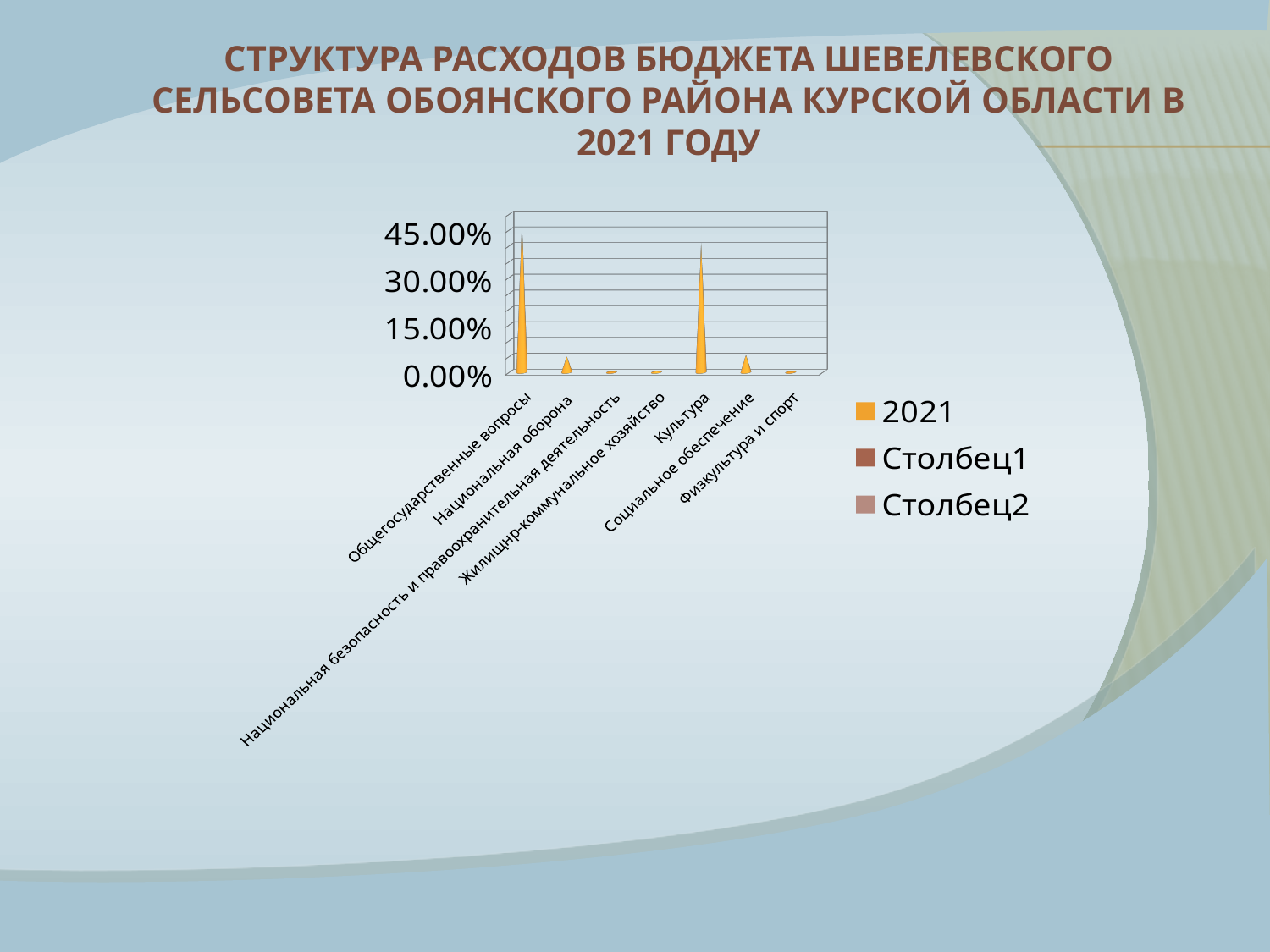
Is the value for Общегосударственные вопросы greater or less than 30.00%? greater Is the value for Национальная оборона greater or less than 15.00%? less How many series does the chart legend list? 3 Is the value for Социальное обеспечение greater or less than 15.00%? less How many expenditure categories are shown on the x axis of the chart? 7 What is the first entry listed in the chart legend? 2021 What is the highest value shown on the chart's vertical axis? 45.00% Which category has the highest value in the chart? Общегосударственные вопросы Which is larger, the value for Культура or the value for Национальная оборона? Культура What kind of chart is shown on the slide? bar chart Which is larger, the value for Общегосударственные вопросы or the value for Культура? Общегосударственные вопросы